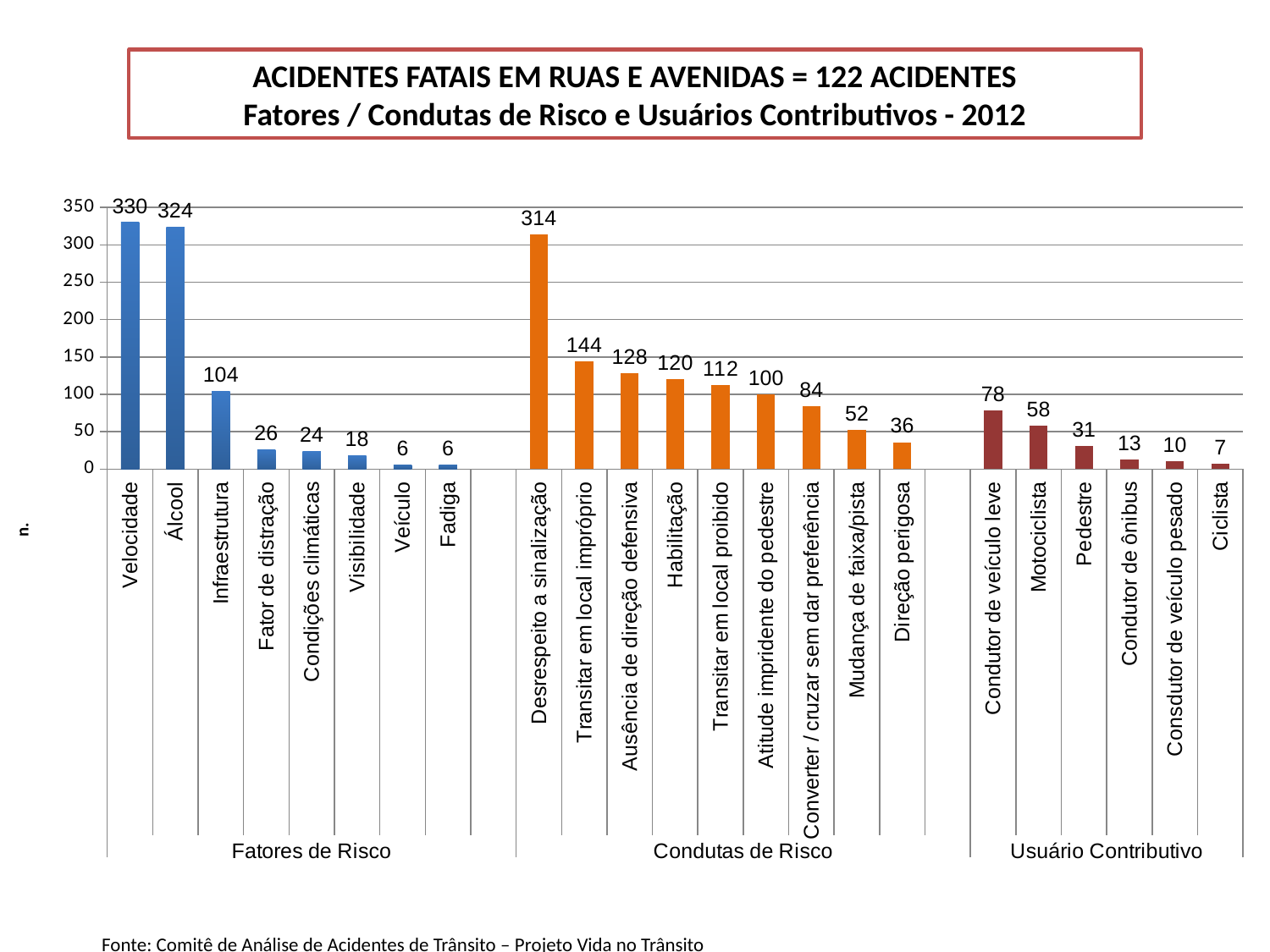
How many bars are in the Condutas de Risco group? 9 What is the value for Converter / cruzar sem dar preferência? 84 What kind of chart is shown on the slide? Bar chart What are the three group labels shown along the bottom of the chart? Fatores de Risco, Condutas de Risco, Usuário Contributivo What is the value for Velocidade? 330 What is the value for Desrespeito a sinalização? 314 What is the difference between the values for Transitar em local impróprio and Ausência de direção defensiva? 16 What is the value for Motociclista? 58 What is the difference between the values for Velocidade and Álcool? 6 Which category in the Usuário Contributivo group has the lowest value? Ciclista Which category has the highest value in the chart? Velocidade Which is larger, the value for Infraestrutura or the value for Condutor de veículo leve? Infraestrutura